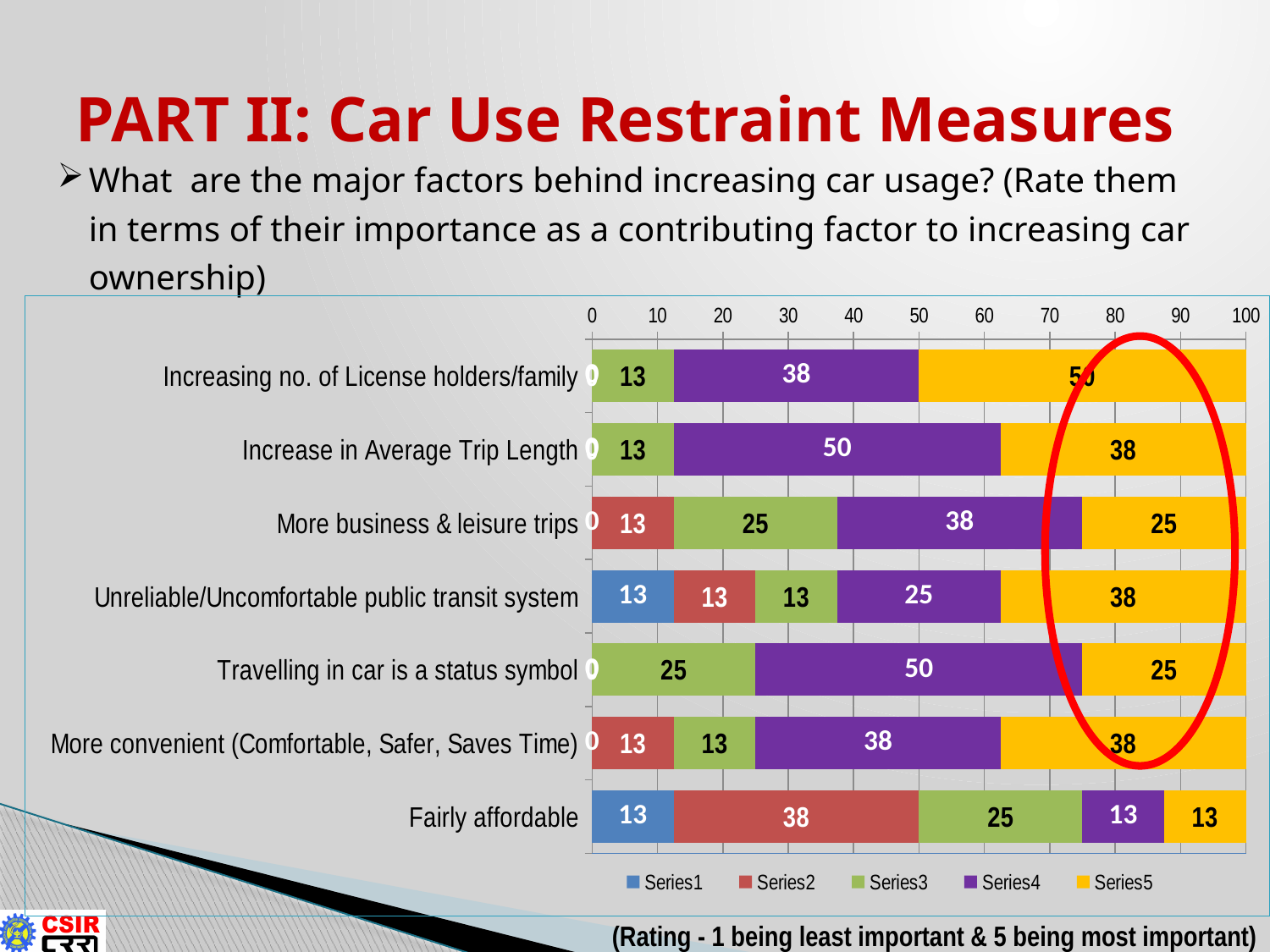
Which category has the lowest Series5 value? Fairly affordable What is the difference between the Series2 value for Fairly affordable and the Series2 value for More convenient (Comfortable, Safer, Saves Time)? 25 What is the Series5 value for Unreliable/Uncomfortable public transit system? 38 What is the Series4 value for Increase in Average Trip Length? 50 What kind of chart is shown on the slide? Stacked bar chart How many series does the legend list? 5 What is the Series4 value for Travelling in car is a status symbol? 50 How many categories are shown on the chart? 7 Which category has the highest Series2 value? Fairly affordable Which is larger: the Series4 value for Increase in Average Trip Length or the Series4 value for Fairly affordable? Increase in Average Trip Length What is the Series2 value for Fairly affordable? 38 What is the Series5 value for Fairly affordable? 13